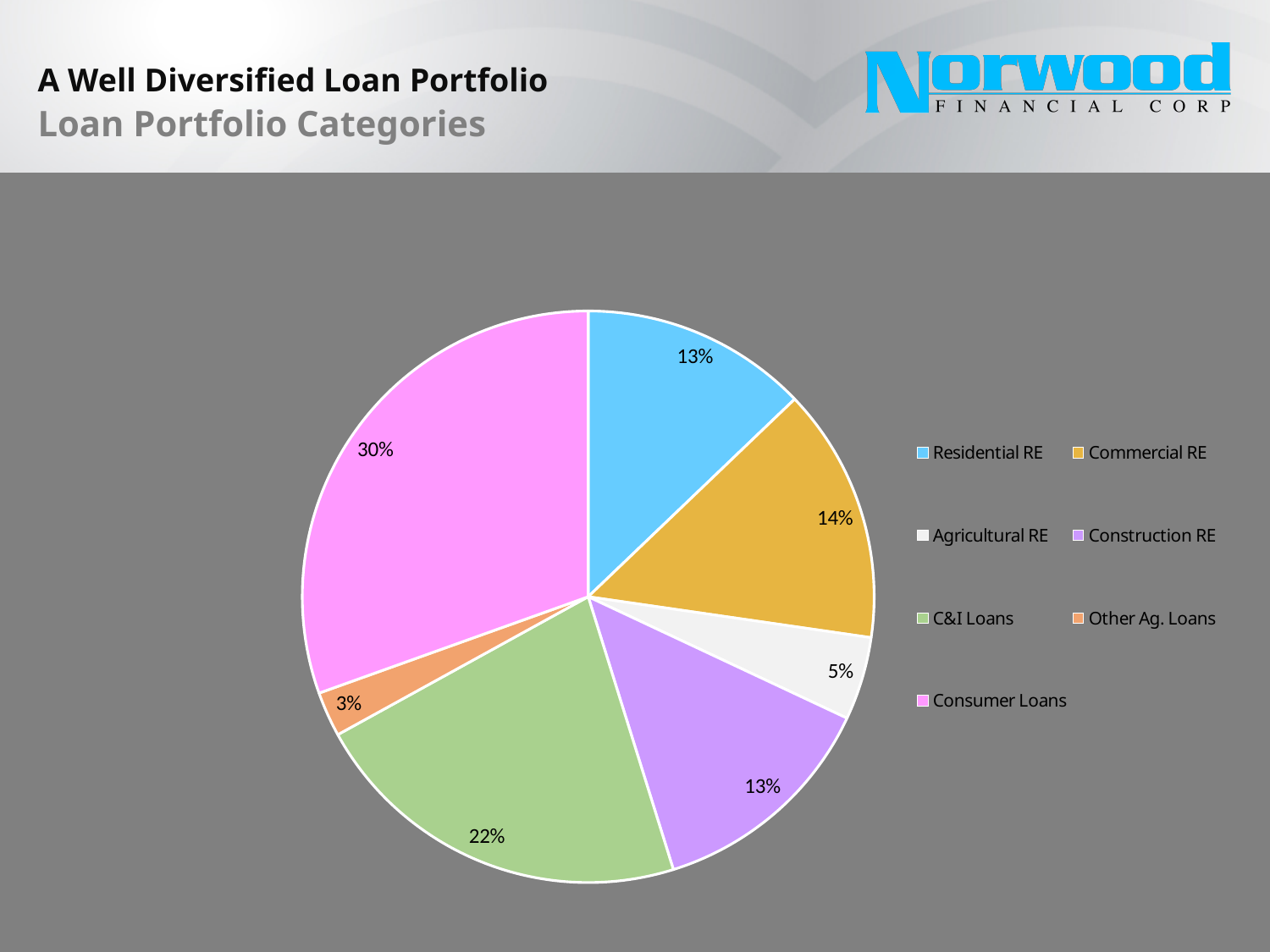
How many percentage points larger is the Consumer Loans share than the C&I Loans share? 8 Which loan category has the largest share of the portfolio? Consumer Loans What share of the loan portfolio is Consumer Loans? 30% What share of the loan portfolio is C&I Loans? 22% Which loan category has the smallest share of the portfolio? Other Ag. Loans What kind of chart is shown on the slide? Pie chart What share of the loan portfolio is Commercial RE? 14% What share of the loan portfolio is Other Ag. Loans? 3% What colour is the Consumer Loans slice? Pink What share of the loan portfolio is Agricultural RE? 5% How many loan categories does the legend list? 7 Which is larger, the Commercial RE share or the Agricultural RE share? Commercial RE